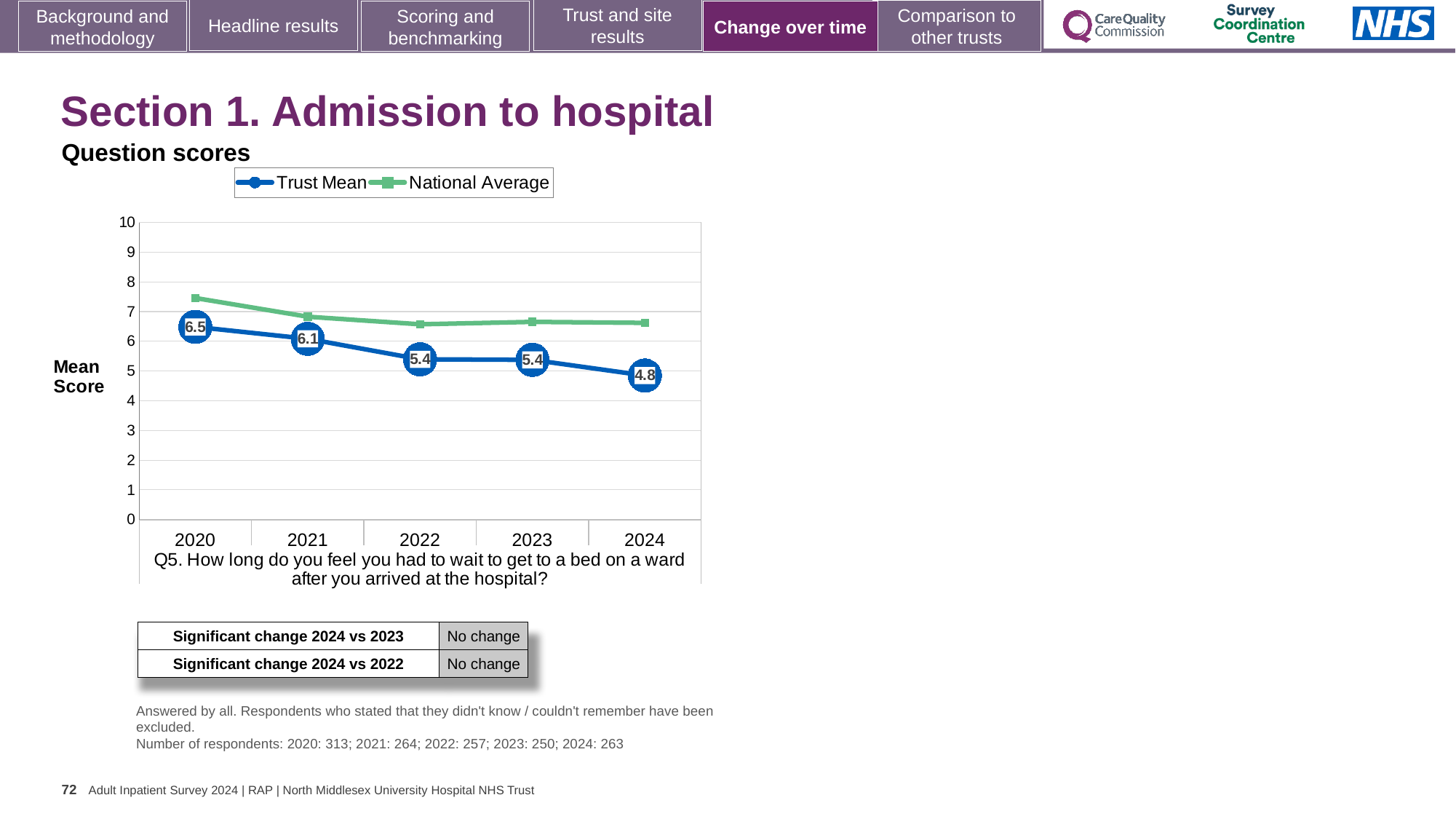
Does the Trust Mean score rise or fall from 2020 to 2024? fall How many years are shown on the x axis? 5 What is the difference between the Trust Mean scores for 2020 and 2024? 1.7 In which year is the Trust Mean score highest? 2020 Which is larger, the Trust Mean score for 2021 or for 2022? 2021 What is the Trust Mean score for 2021? 6.1 In which year is the Trust Mean score lowest? 2024 What is the Trust Mean score for 2020? 6.5 What is the Trust Mean score for 2024? 4.8 Is the National Average value for 2024 greater or less than 7? less Is the National Average value for 2020 greater or less than 7? greater How many series does the legend list? 2